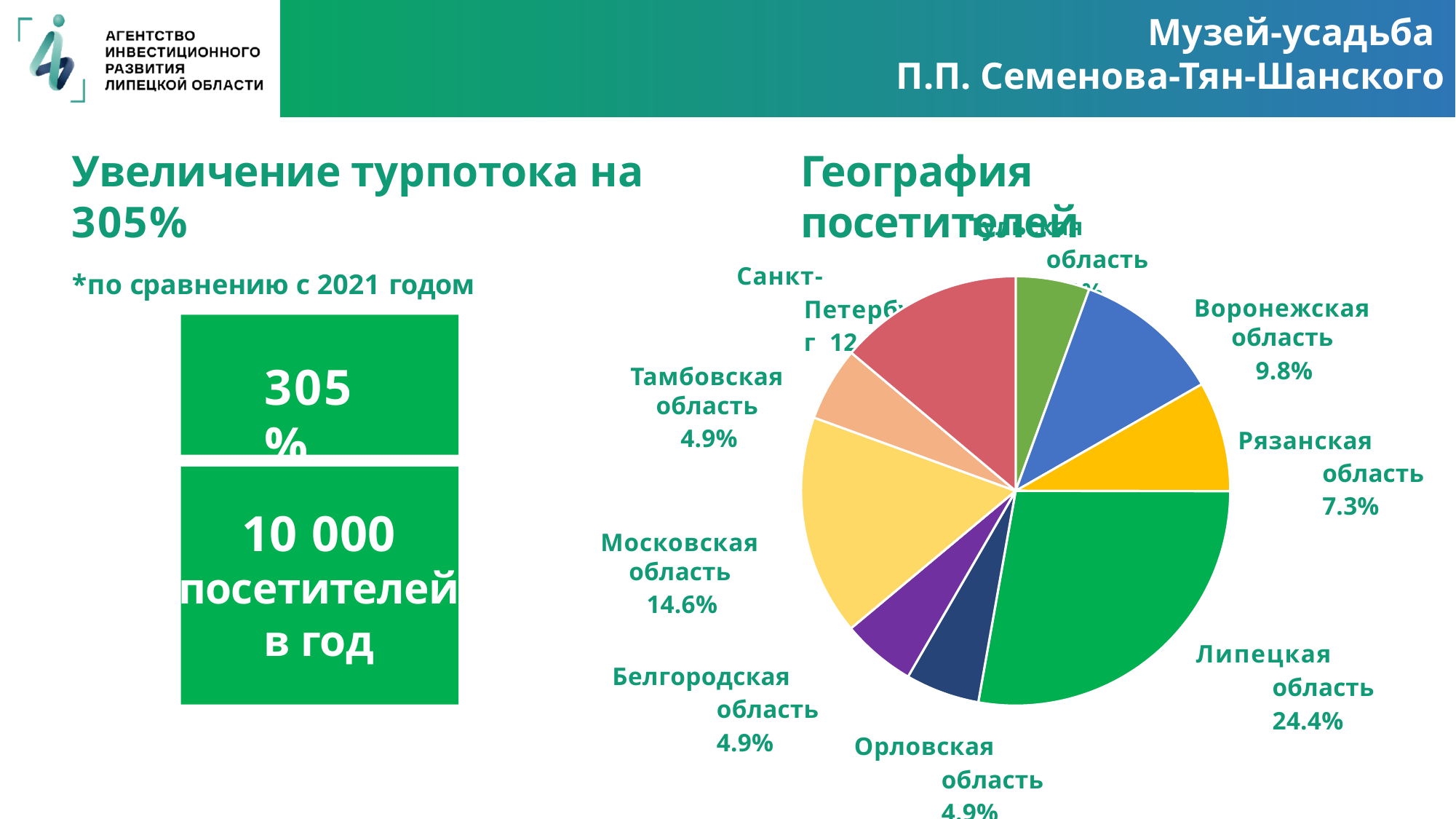
Which region has the largest slice in the pie chart? Липецкая область What is the difference between the shares of Липецкая область and Московская область? 9.8% What share of visitors comes from Липецкая область? 24.4% What kind of chart is shown under the heading "География посетителей"? pie chart What share of visitors comes from Рязанская область? 7.3% What share of visitors comes from Тамбовская область? 4.9% What share of visitors comes from Воронежская область? 9.8% What share of visitors comes from Московская область? 14.6% How many slices does the pie chart have? 9 Which is larger in the pie chart: the share for Московская область or for Воронежская область? Московская область What is the difference between the shares of Воронежская область and Рязанская область? 2.5% What is the title of the pie chart? География посетителей